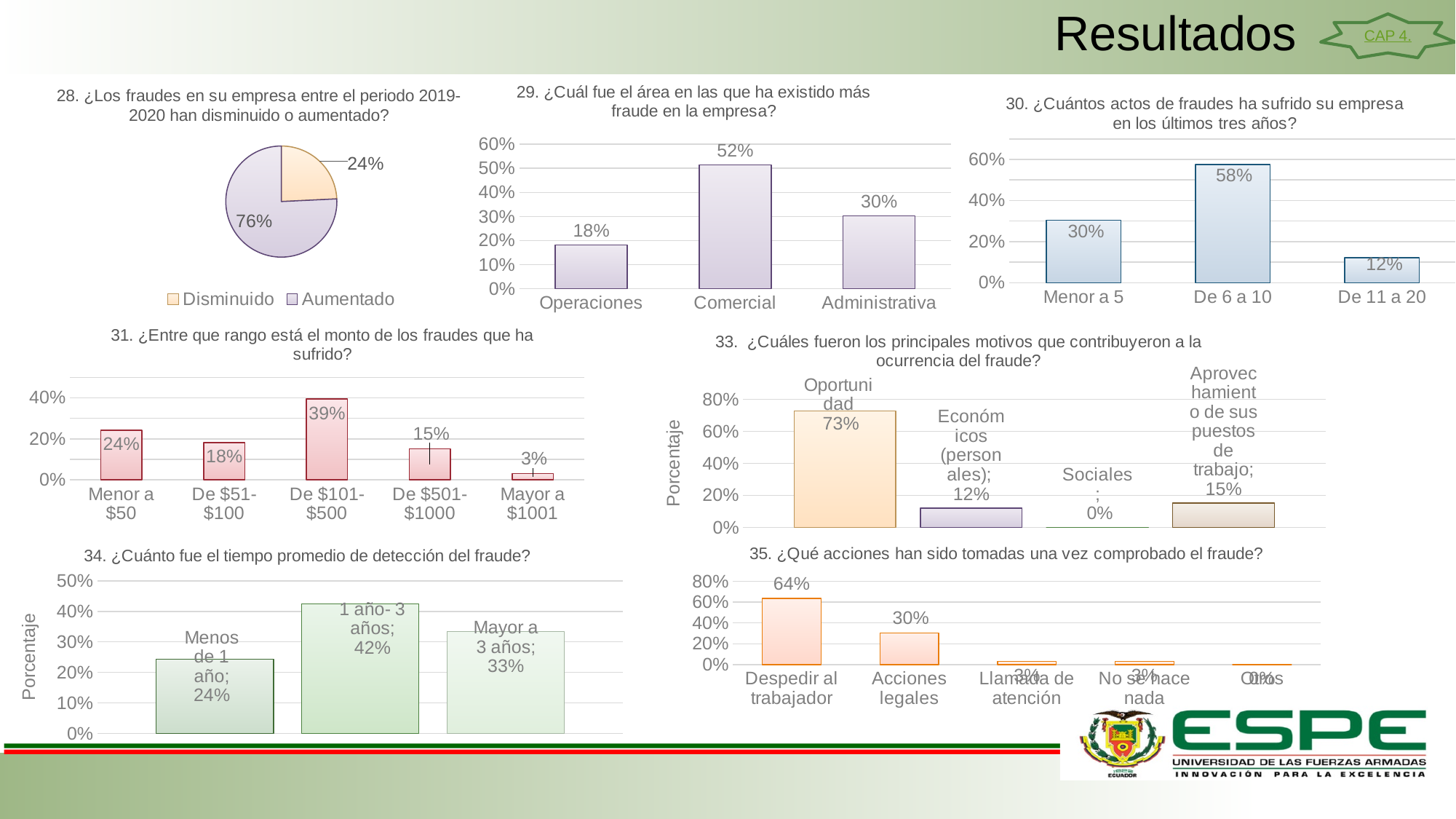
In the chart for question 28 (pie chart, top left), what percentage corresponds to 'Aumentado'? 76% In the chart for question 31 (middle left), how many categories are shown on the x axis? 5 In the chart for question 35 (bottom right), what is the value for 'Despedir al trabajador'? 64% In the chart for question 29 (top centre), what is the value for Operaciones? 18% In the chart for question 33 (middle right), which is larger: 'Económicos (personales)' or 'Aprovechamiento de sus puestos de trabajo'? Aprovechamiento de sus puestos de trabajo In the chart for question 30 (top right), what is the difference between 'De 6 a 10' and 'De 11 a 20'? 46% In the chart for question 33 (middle right), what is the value for 'Sociales'? 0% In the chart for question 31 (middle left), what is the value for 'De $101-$500'? 39% In the chart for question 30 (top right), which category has the lowest value? De 11 a 20 In the chart for question 28 (pie chart, top left), what share of the pie does 'Disminuido' represent? 24% In the chart for question 34 (bottom left), what is the value for '1 año- 3 años'? 42% In the chart for question 29 (top centre), which area has the highest value? Comercial